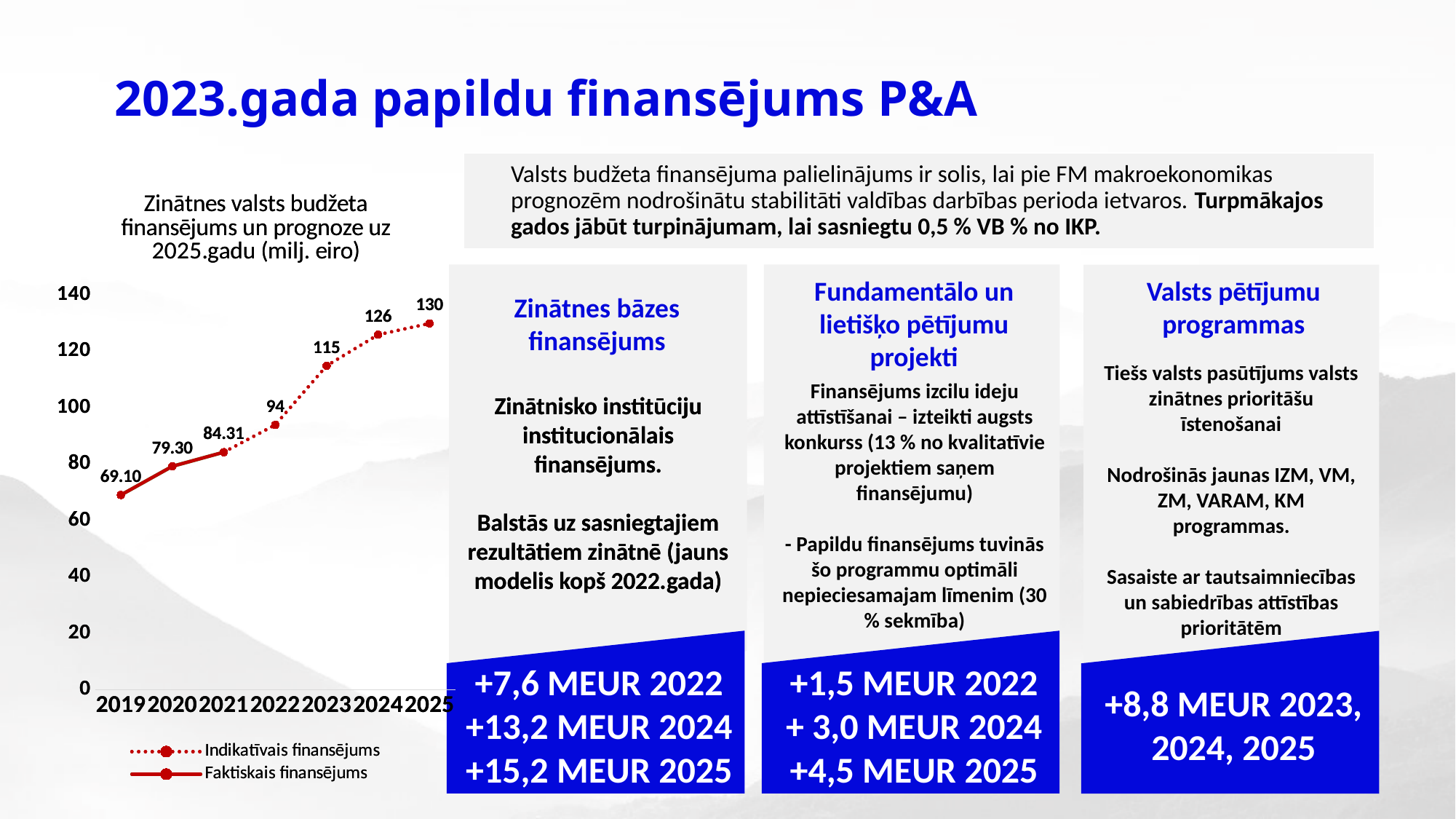
What is the value shown for 2019 in the chart? 69.10 How many years are plotted on the x axis of the chart? 7 Which year has the lowest value in the chart? 2019 What is the value shown for 2021 in the chart? 84.31 Which year has the highest value in the chart? 2025 How many series does the chart legend list? 2 What is the difference between the values for 2024 and 2023? 11 Which is larger, the value for 2020 or the value for 2022? 2022 What is the value shown for 2025 in the chart? 130 Do the values rise or fall from 2019 to 2025? rise What kind of chart is shown on the slide? line chart What is the value shown for 2023 in the chart? 115